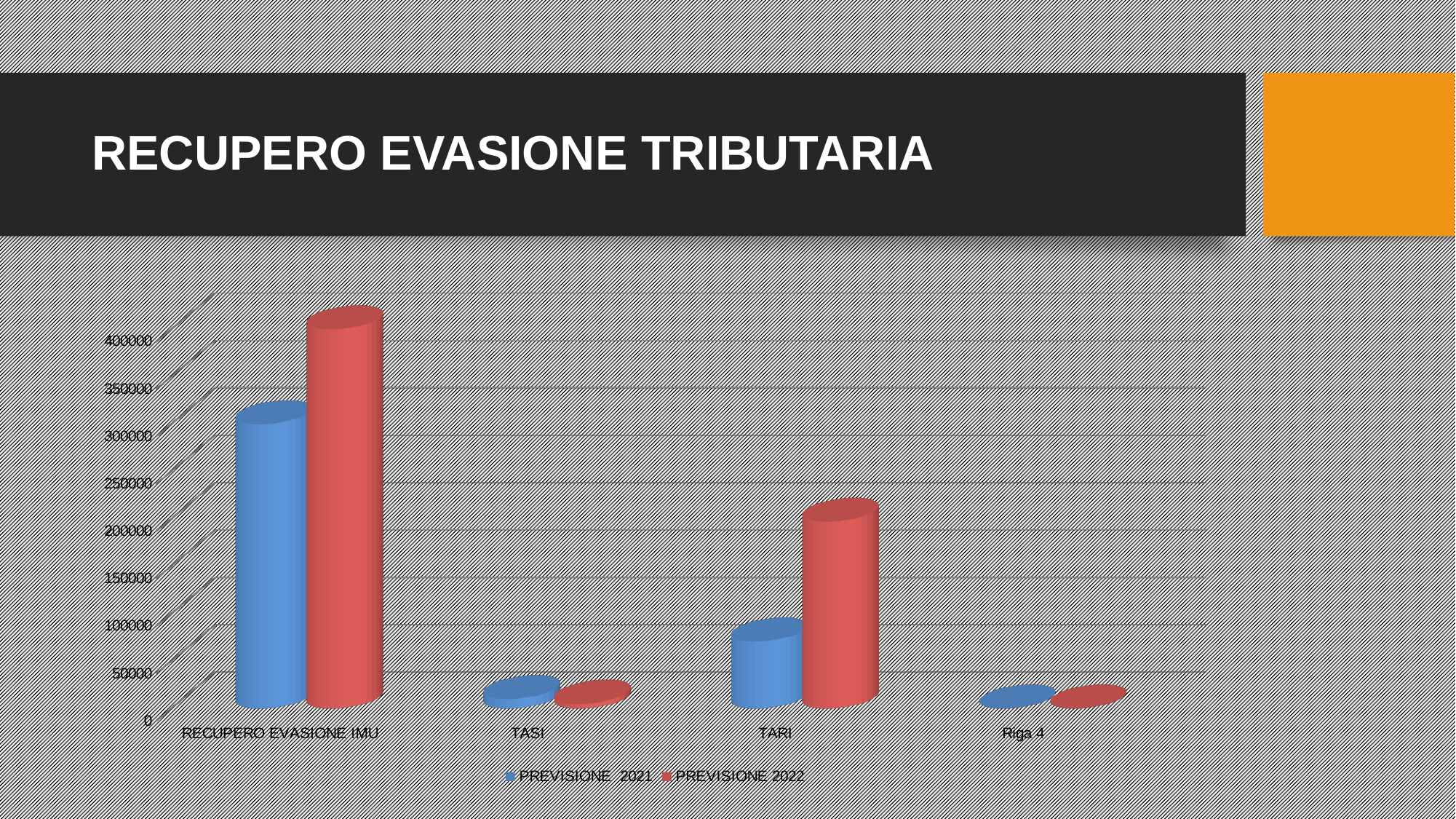
Which category has the highest value for PREVISIONE 2021? RECUPERO EVASIONE IMU For TARI, which is larger: PREVISIONE 2021 or PREVISIONE 2022? PREVISIONE 2022 Is the PREVISIONE 2022 value for TASI greater or less than 50000? less What kind of chart is shown on the slide? bar chart What is the title of the slide containing the chart? RECUPERO EVASIONE TRIBUTARIA How many series does the chart legend list? 2 Is the PREVISIONE 2022 value for RECUPERO EVASIONE IMU greater or less than 350000? greater Which series is shown in red in the chart? PREVISIONE 2022 How many categories are shown on the x axis of the chart? 4 For RECUPERO EVASIONE IMU, which is larger: PREVISIONE 2021 or PREVISIONE 2022? PREVISIONE 2022 Which category has the highest value for PREVISIONE 2022? RECUPERO EVASIONE IMU Is the PREVISIONE 2021 value for TARI greater or less than 150000? less